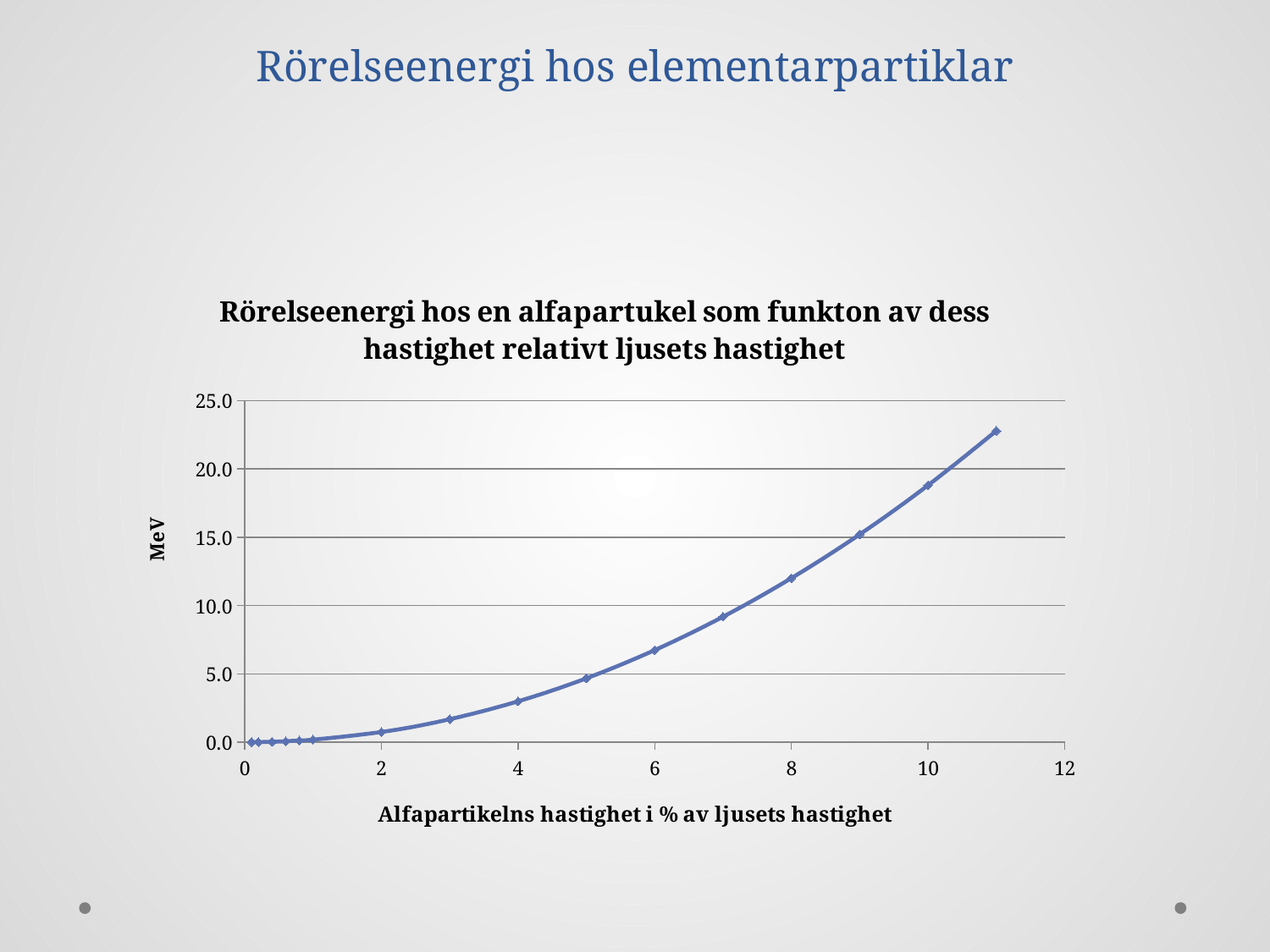
What is the label of the y axis? MeV Is the value at 10% of the speed of light greater or less than 15.0 MeV? greater Is the value at 11% of the speed of light greater or less than 20.0 MeV? greater Is the value at 4% of the speed of light greater or less than 5.0 MeV? less Which plotted point has the highest energy value? 11 What is the label of the x axis? Alfapartikelns hastighet i % av ljusets hastighet What kind of chart is shown on the slide? line chart Do the values rise or fall as the alpha particle's speed increases along the x axis? rise